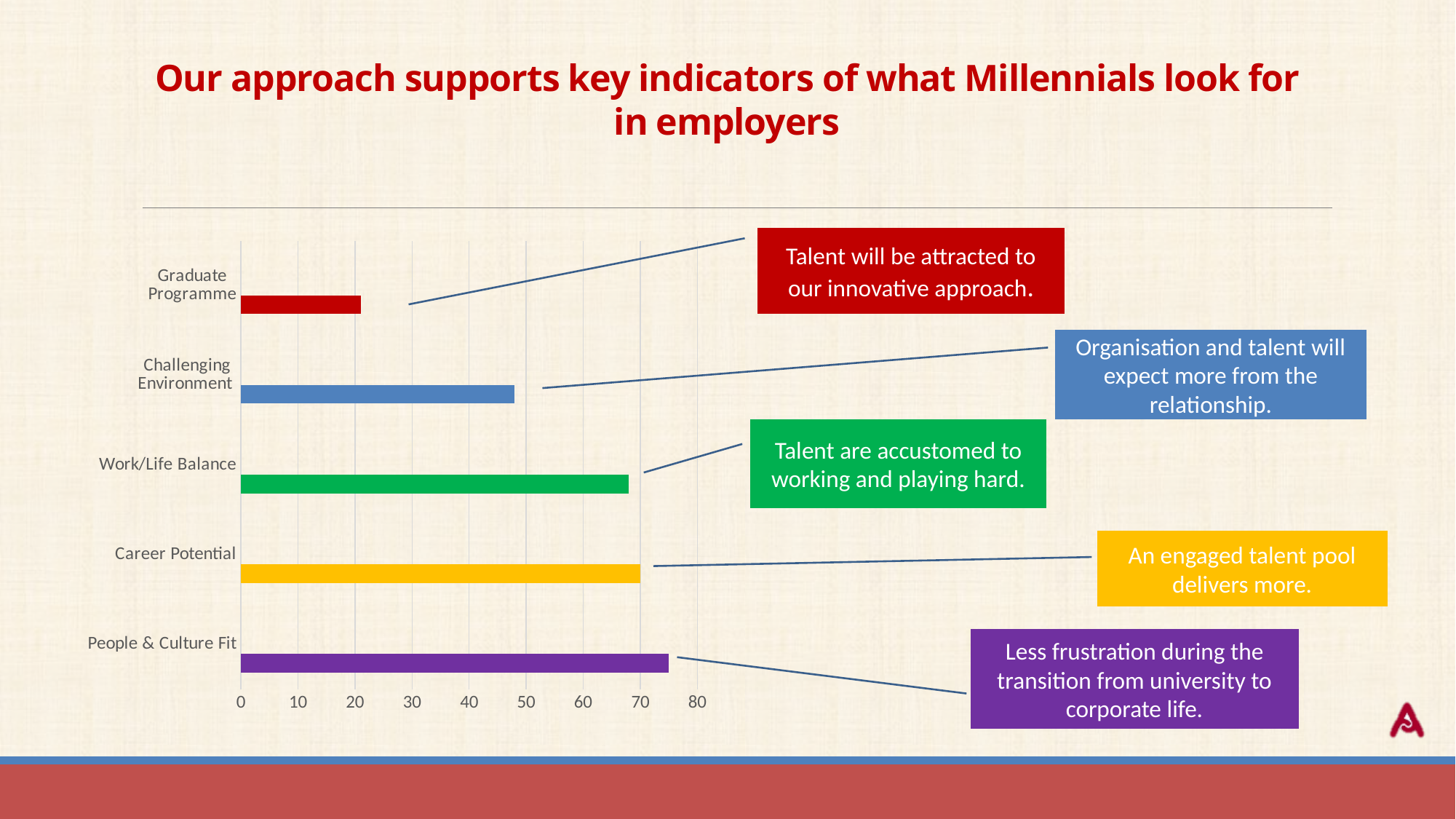
Is the value for People & Culture Fit greater or less than 70? greater Which category has the shortest bar? Graduate Programme Is the value for Work/Life Balance greater or less than 60? greater Which is larger, the value for Challenging Environment or the value for Work/Life Balance? Work/Life Balance What colour is the bar for Work/Life Balance? Green What kind of chart is shown on the slide? Bar chart Is the value for Challenging Environment greater or less than 50? less Which category has the longest bar? People & Culture Fit What is the highest value shown on the horizontal axis? 80 Which is larger, the value for Graduate Programme or the value for Career Potential? Career Potential How many categories are plotted in the chart? 5